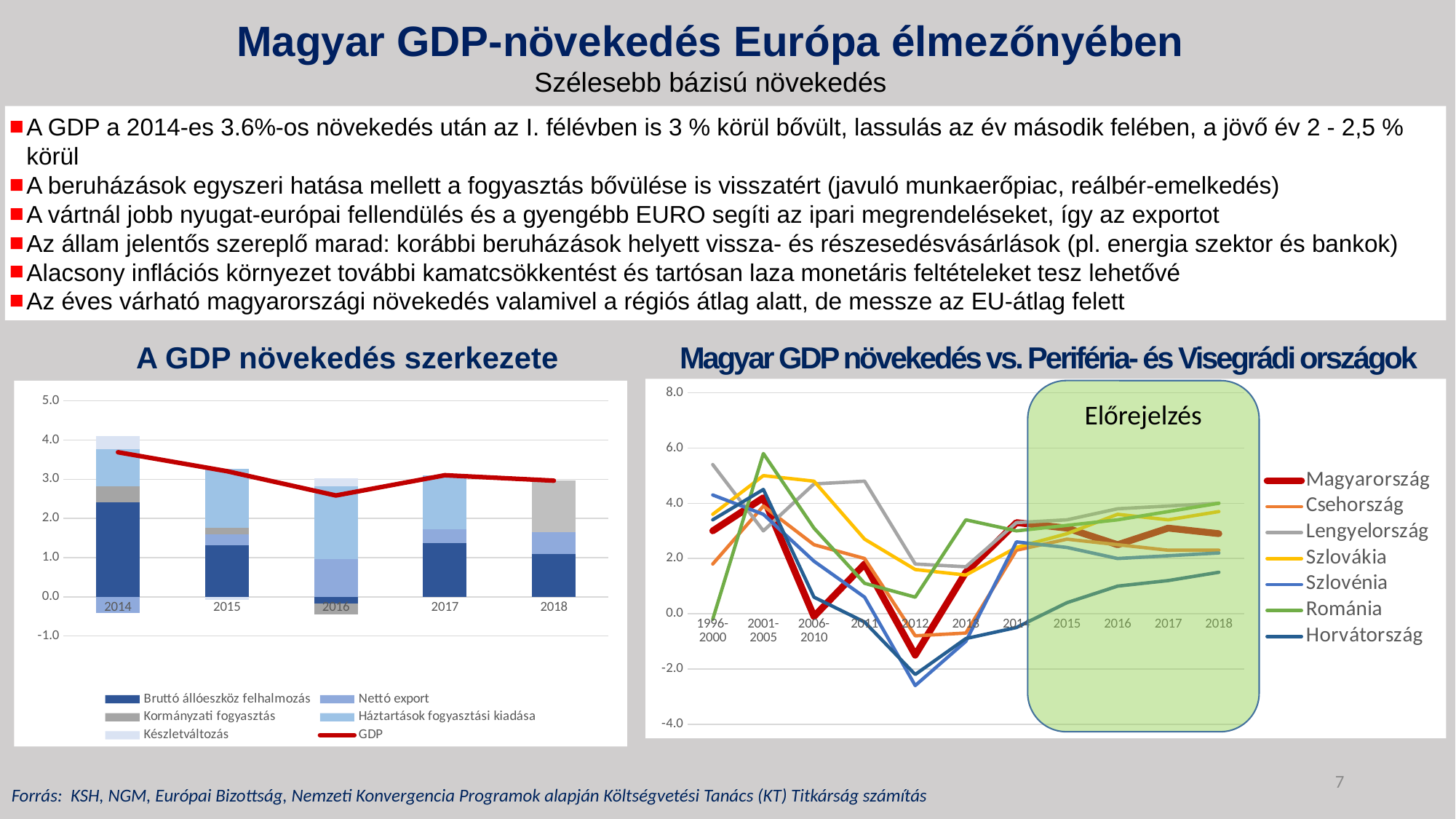
How many points are on the x axis of 'Magyar GDP növekedés vs. Periféria- és Visegrádi országok'? 11 How many years are shown on the x axis of 'A GDP növekedés szerkezete'? 5 In 'Magyar GDP növekedés vs. Periféria- és Visegrádi országok', is the value for Magyarország in 2012 greater or less than 0.0? less In 'A GDP növekedés szerkezete', does the GDP line rise or fall from 2014 to 2016? fall What kind of chart is 'A GDP növekedés szerkezete'? Stacked bar chart with a line How many entries does the legend of 'A GDP növekedés szerkezete' list? 6 How many series does the legend of 'Magyar GDP növekedés vs. Periféria- és Visegrádi országok' list? 7 In 'A GDP növekedés szerkezete', is the GDP line value for 2016 greater or less than 3.0? less In 'A GDP növekedés szerkezete', is the GDP line value for 2014 greater or less than 3.0? greater In 'Magyar GDP növekedés vs. Periféria- és Visegrádi országok', what label appears in the green shaded area? Előrejelzés What kind of chart is 'Magyar GDP növekedés vs. Periféria- és Visegrádi országok'? Line chart In 'Magyar GDP növekedés vs. Periféria- és Visegrádi országok', which series has the highest value in 2001-2005? Románia